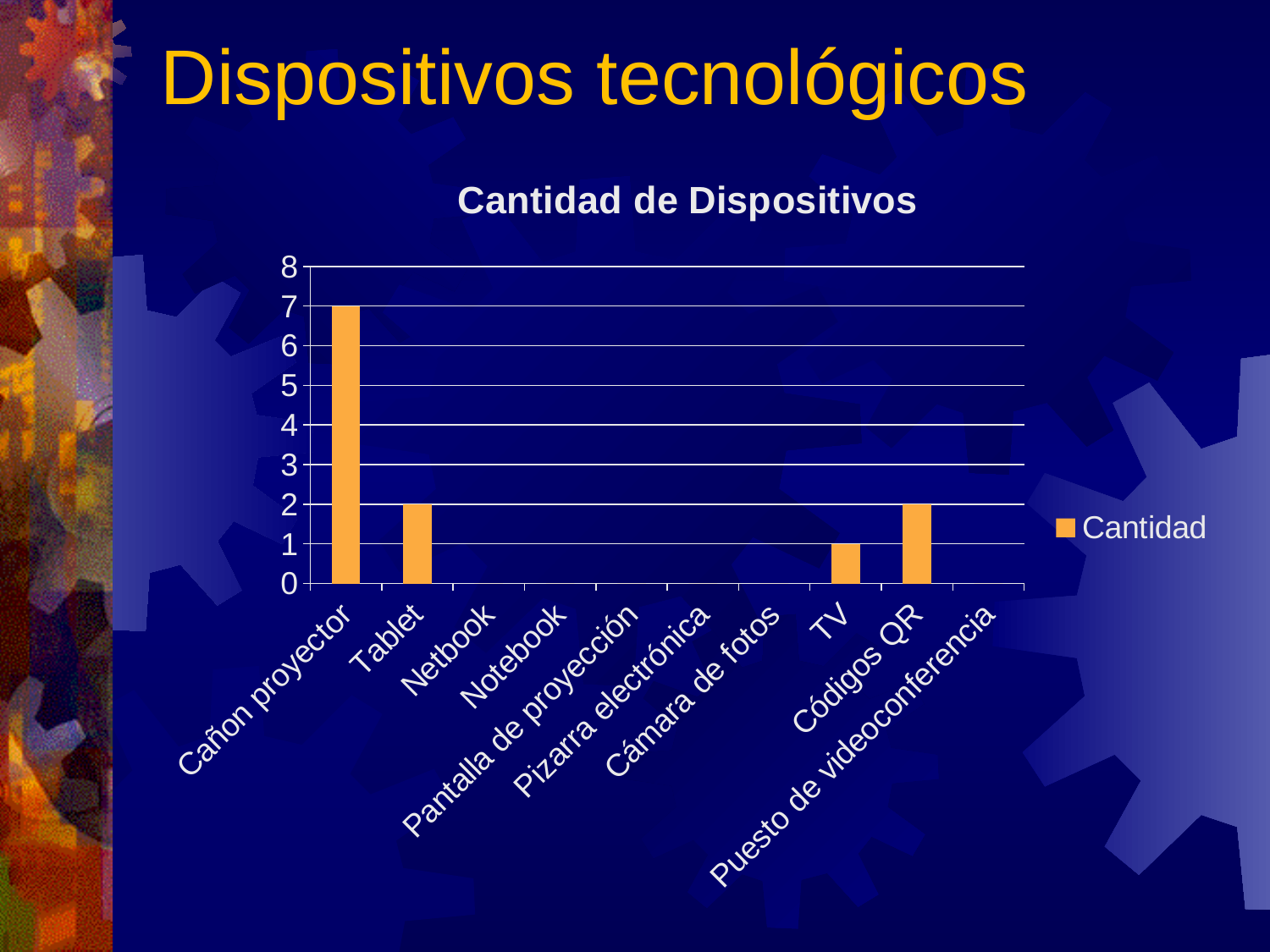
What is the difference between the values for Cañon proyector and Tablet? 5 How many series does the legend list? 1 Which category has the highest value? Cañon proyector Which is larger, the value for Tablet or the value for TV? Tablet What is the value for Tablet? 2 What is the value for TV? 1 What is the value for Cañon proyector? 7 How many categories are shown on the x axis? 10 Is the value for Cañon proyector greater or less than 5? greater What kind of chart is shown? bar chart What is the title of the chart? Cantidad de Dispositivos What is the value for Códigos QR? 2